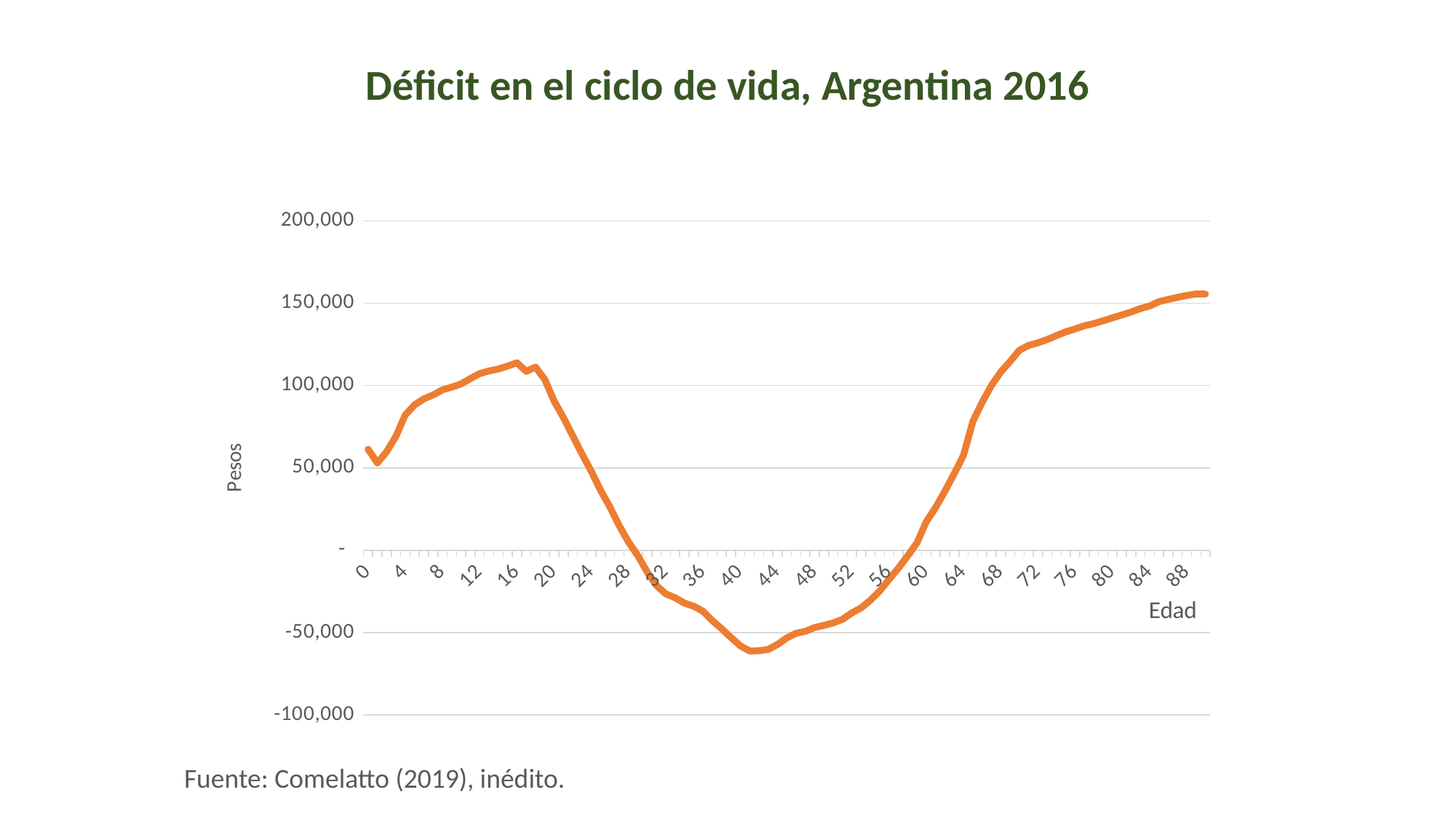
Between age 20 and age 40, do the values rise or fall? Fall Which is larger, the value at age 8 or the value at age 36? Age 8 Is the value at age 72 greater or less than 100,000? greater Is the value at age 80 greater or less than 150,000? less Is the value at age 0 greater or less than 50,000? greater What is the title of the chart? Déficit en el ciclo de vida, Argentina 2016 What kind of chart is shown on the slide? Line chart Which is larger, the value at age 16 or the value at age 88? Age 88 Between age 48 and age 88, do the values rise or fall? Rise What label is shown on the vertical axis of the chart? Pesos